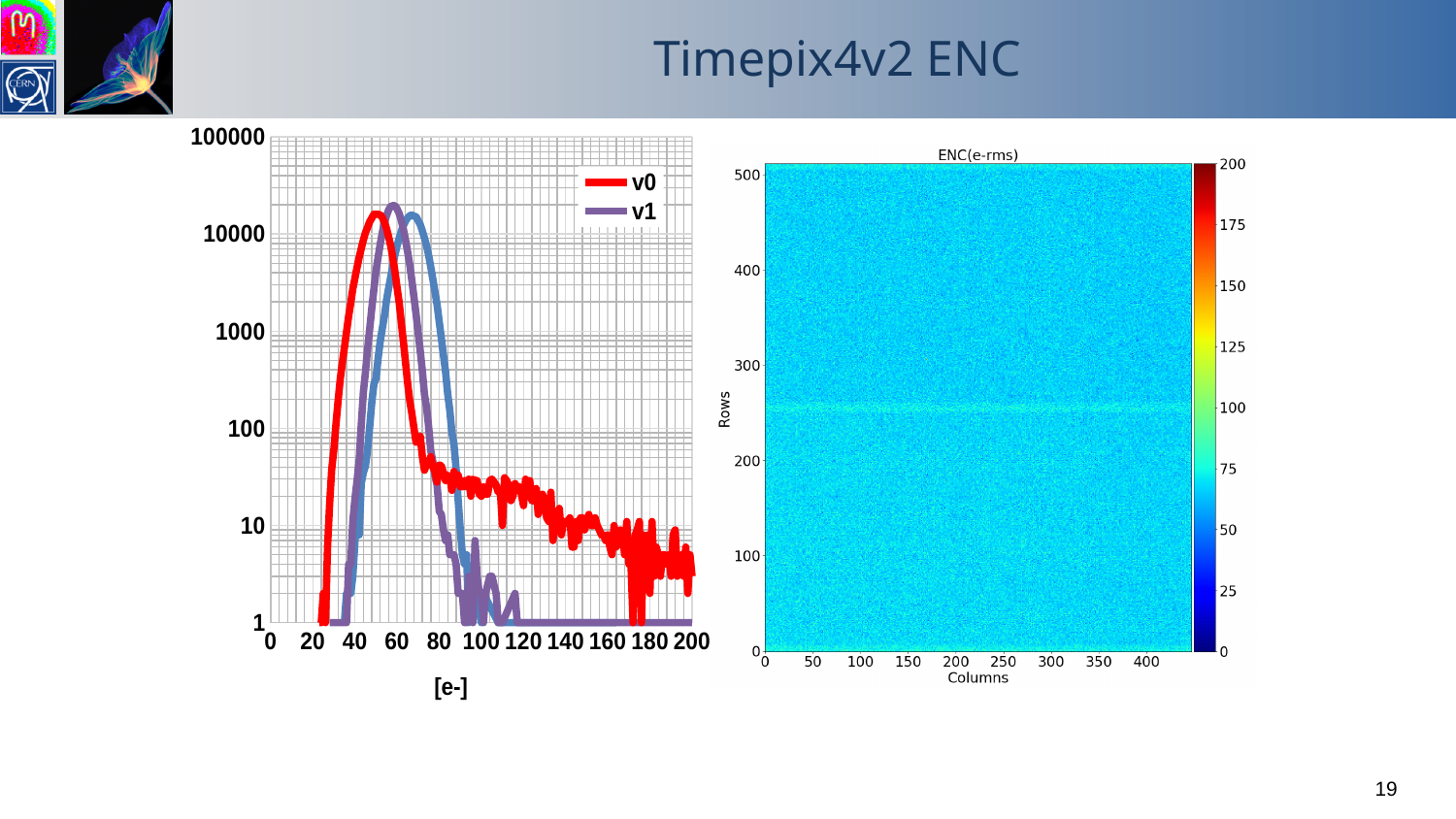
On the left chart, is the peak value of v0 greater or less than 10000? greater On the left chart, is the value of v0 at 200 [e-] greater or less than 10? less What kind of chart is the left chart? line chart On the left chart, what are the names of the series in the legend? v0 and v1 On the left chart, does the v0 curve rise or fall as [e-] increases from 100 to 200? fall On the left chart, which series reaches its peak at a lower [e-] value, v0 or v1? v0 What is the x-axis label of the left chart? [e-] What is the title of the right chart? ENC(e-rms) On the right chart, what is the highest tick value shown on the Rows axis? 500 On the right chart, what is the maximum value shown on the colour bar? 200 On the left chart, is the peak value of v1 greater or less than 10000? greater On the left chart, how many series does the legend list? 2